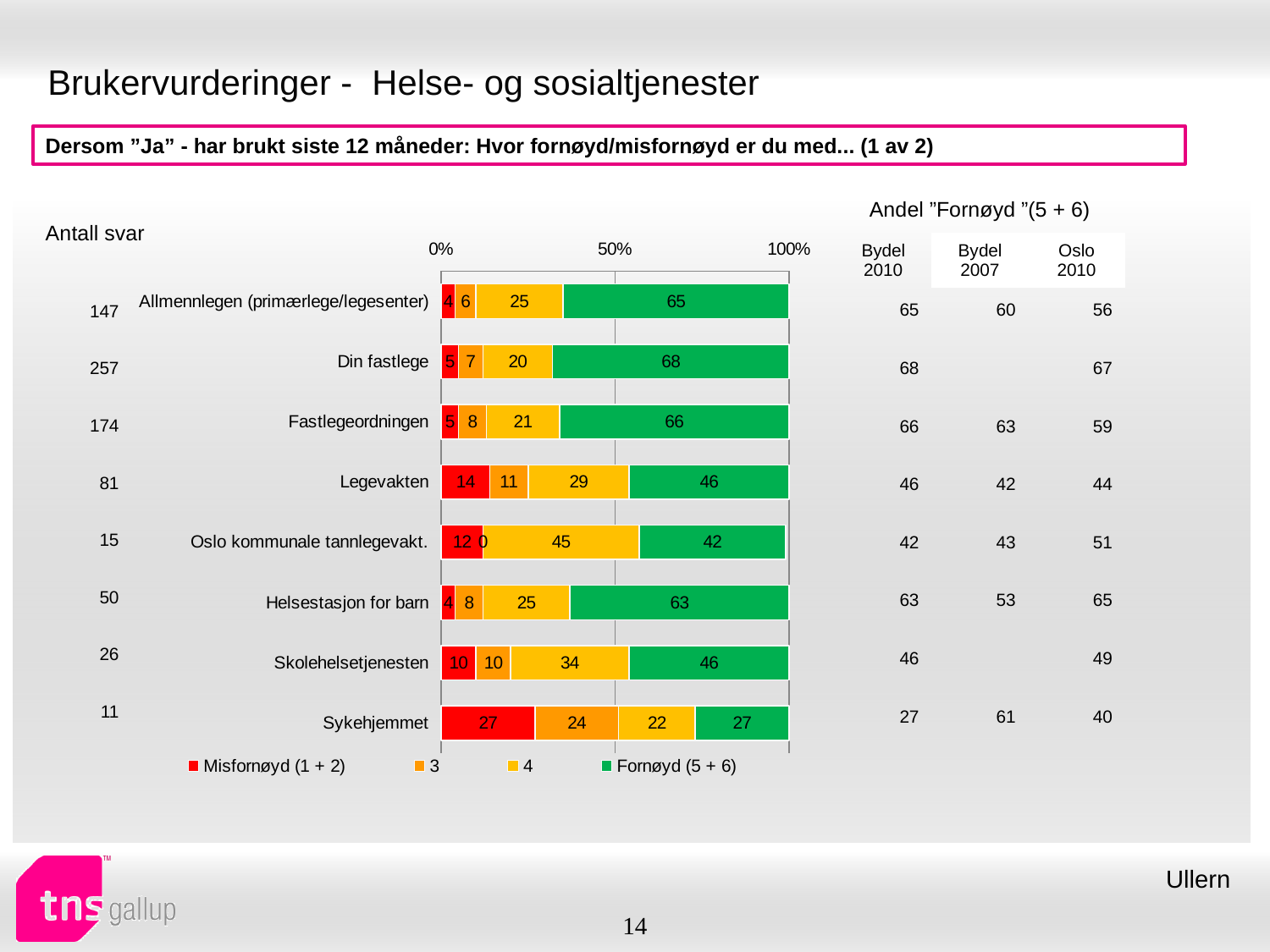
What is the value of the "Misfornøyd (1 + 2)" segment for Legevakten? 14 How many categories are shown in the chart? 8 What is the total of the stacked bar for Sykehjemmet? 100 What kind of chart is shown on the slide? Stacked bar chart Which has a larger "Misfornøyd (1 + 2)" value, Sykehjemmet or Skolehelsetjenesten? Sykehjemmet What is the value of the "Fornøyd (5 + 6)" segment for Din fastlege? 68 How many series does the legend list? 4 Which category has the lowest "Fornøyd (5 + 6)" value? Sykehjemmet What colour represents the "Fornøyd (5 + 6)" series in the chart? Green What is the value of the "4" segment for Oslo kommunale tannlegevakt.? 45 Which category has the highest "Fornøyd (5 + 6)" value? Din fastlege What is the difference between the "Fornøyd (5 + 6)" values for Allmennlegen (primærlege/legesenter) and Legevakten? 19